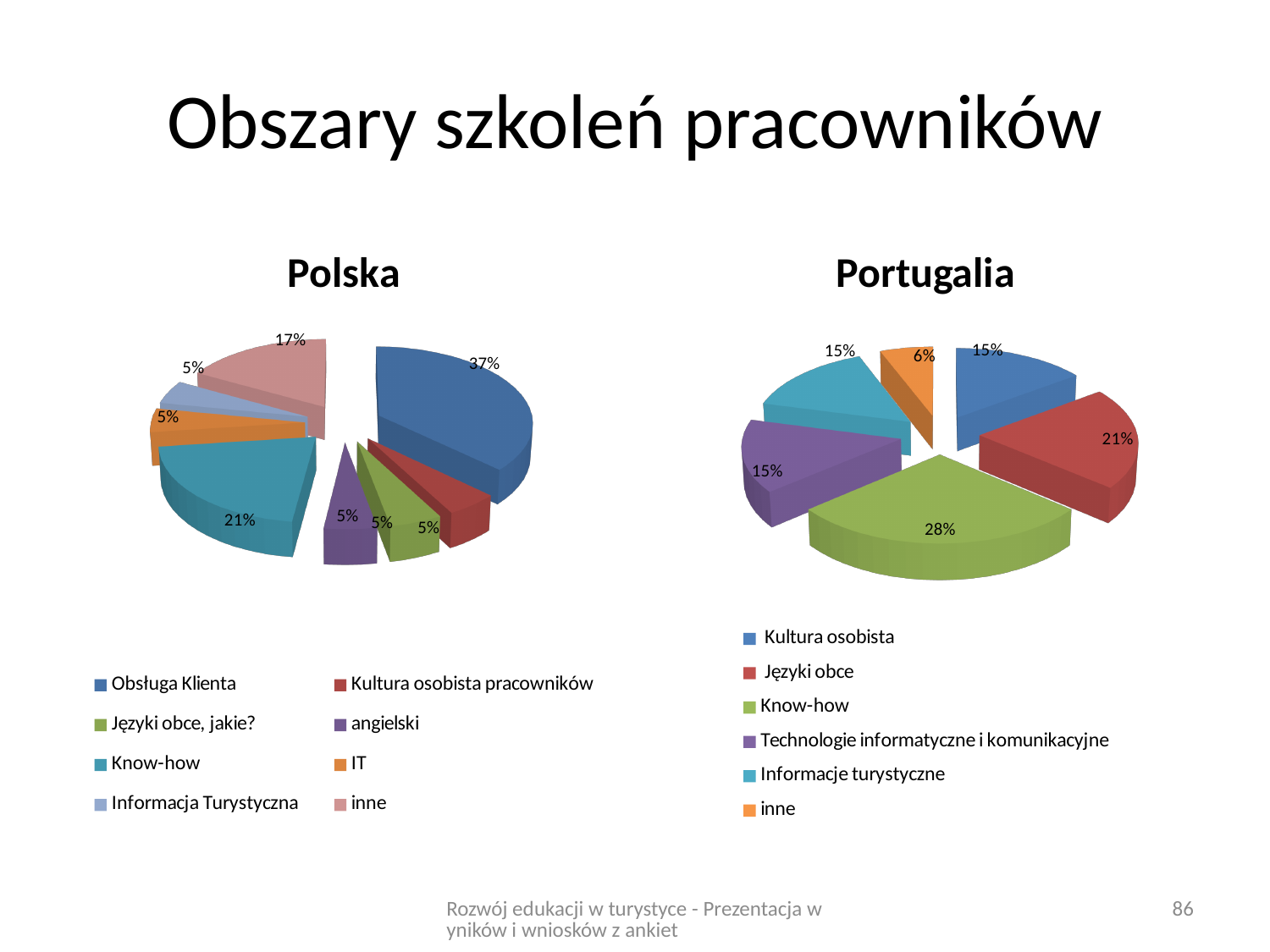
In the Polska chart, which category has the largest share? Obsługa Klienta In the Portugalia chart, what is the difference between the Know-how share and the Języki obce share? 7% In the Portugalia chart, how many categories does the legend list? 6 In the Portugalia chart, what share does Know-how have? 28% What kind of chart is used for Polska and Portugalia? Pie chart In the Polska chart, what share does inne have? 17% In the Polska chart, what share does Obsługa Klienta have? 37% In the Portugalia chart, which category has the largest share? Know-how In the Portugalia chart, which category has the smallest share? inne In the Portugalia chart, what share does Języki obce have? 21% In the Polska chart, how many slices does the pie have? 8 In the Polska chart, what share does Know-how have? 21%